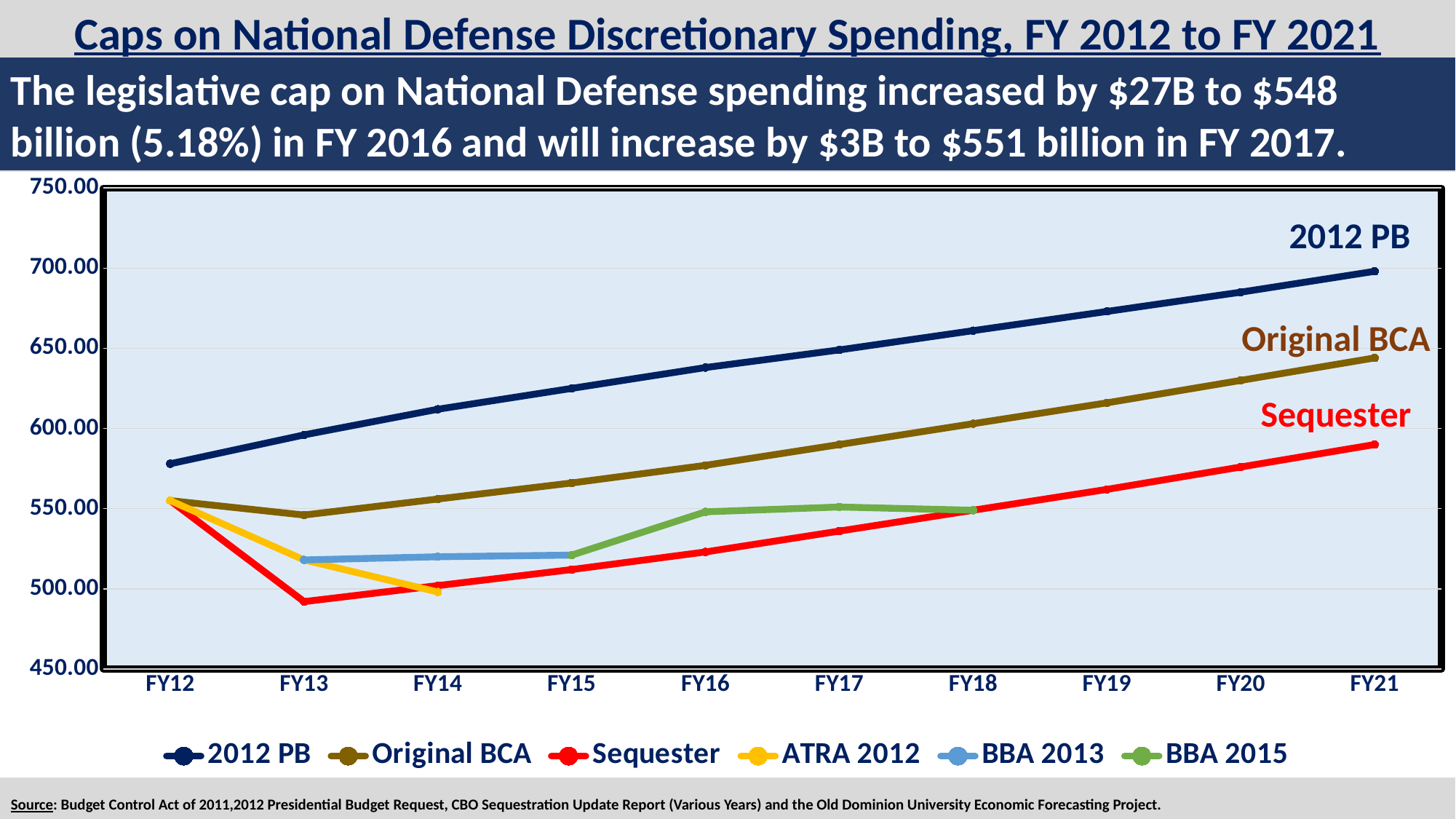
Which series has the lowest value at FY13? Sequester Does the 2012 PB line rise or fall from FY12 to FY21? Rise What is the title of the chart? Caps on National Defense Discretionary Spending, FY 2012 to FY 2021 What kind of chart is shown on the slide? Line chart Is the value for Sequester at FY13 greater or less than 500? less At FY17, which is larger: 2012 PB or Original BCA? 2012 PB Is the value for 2012 PB at FY16 greater or less than 600? greater Is the value for BBA 2013 at FY14 greater or less than 500? greater How many series does the legend list? 6 How many fiscal years are shown on the x axis? 10 Which series has the highest value at FY21? 2012 PB